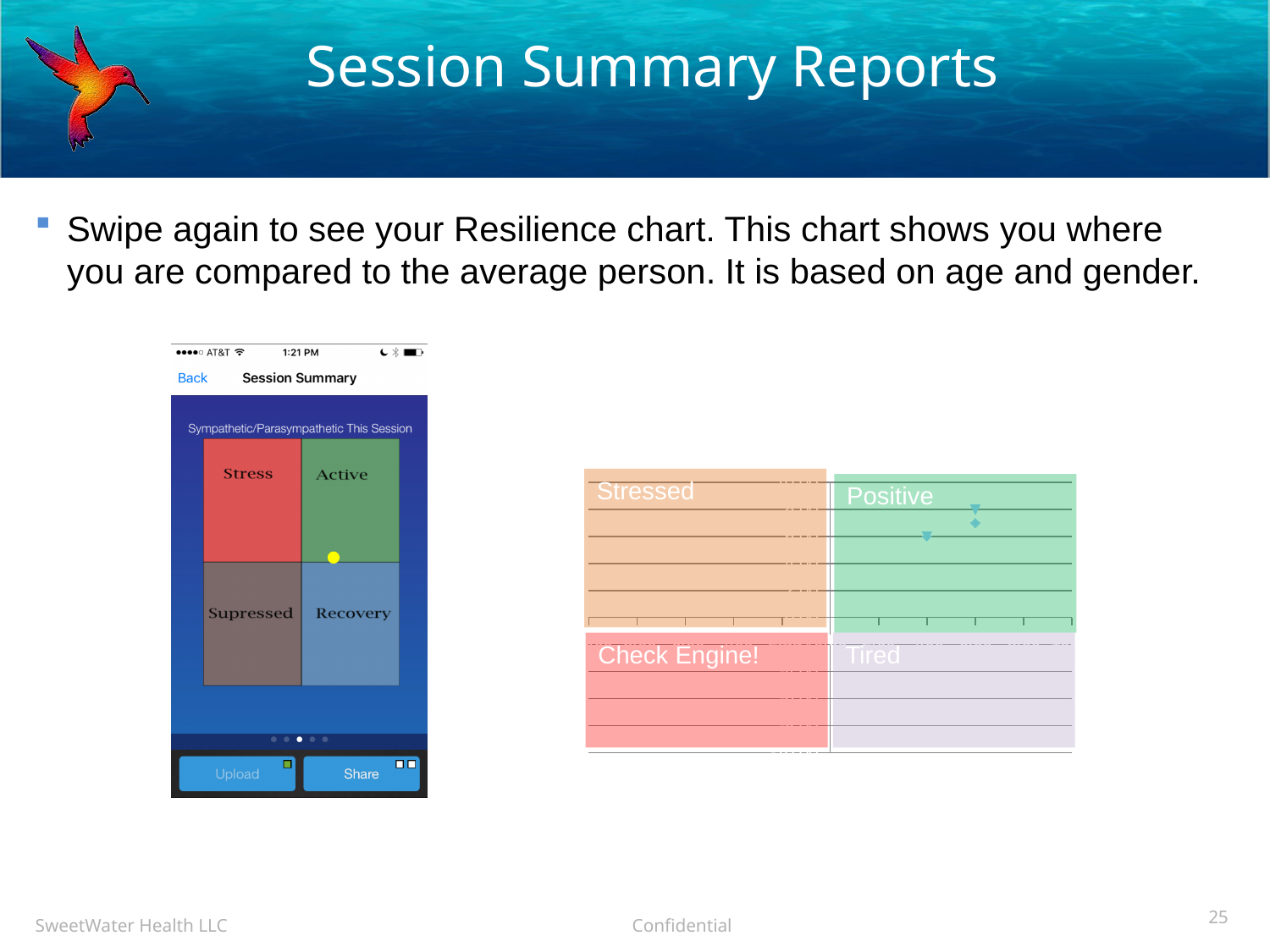
On the chart on the right, how many labelled quadrants are shown? 4 On the phone screenshot chart on the left, how many labelled quadrants are shown? 4 On the phone screenshot chart on the left, what is the chart's title? Sympathetic/Parasympathetic This Session On the chart on the right, which quadrant contains the plotted markers? Positive On the chart on the right, what is the label of the bottom-left quadrant? Check Engine!